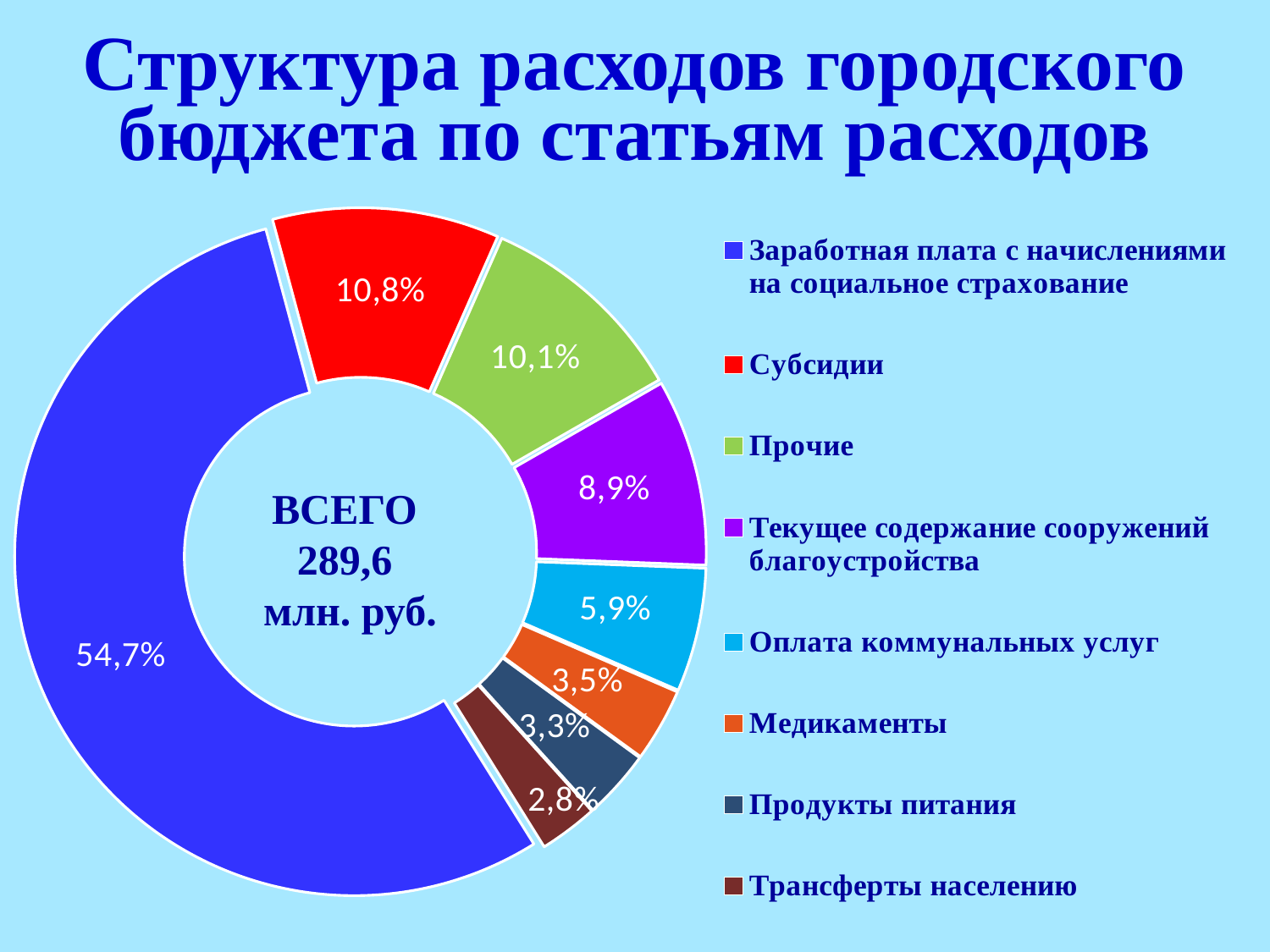
What type of chart is shown on the slide? Doughnut (pie) chart Which expenditure item has the smallest share of the city budget? Трансферты населению What percentage is shown for «Оплата коммунальных услуг»? 5,9% What is the difference in percentage points between «Субсидии» and «Прочие»? 0,7 What share of expenditures is shown for «Субсидии»? 10,8% What colour represents «Текущее содержание сооружений благоустройства» in the chart? Purple Which has a larger share: «Медикаменты» or «Оплата коммунальных услуг»? Оплата коммунальных услуг What share of the city budget expenditures goes to «Заработная плата с начислениями на социальное страхование»? 54,7% Which expenditure item has the largest share of the city budget? Заработная плата с начислениями на социальное страхование What percentage is shown for «Трансферты населению»? 2,8% How many expenditure items are shown in the chart? 8 What total amount of expenditures is shown in the centre of the chart? 289,6 млн. руб.